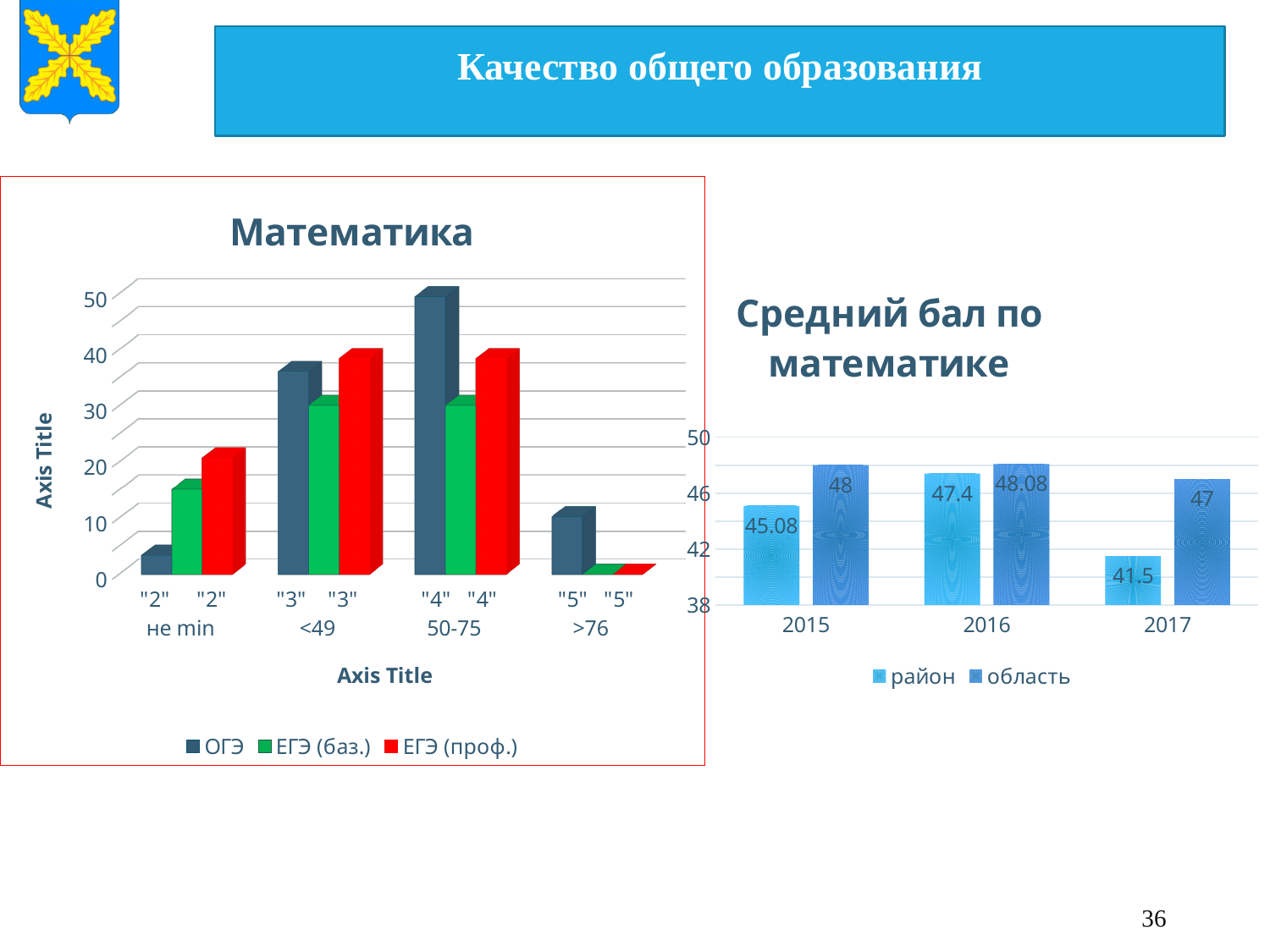
In the chart titled "Математика", how many series does the legend list? 3 In the chart titled "Средний бал по математике", what is the value for район in 2015? 45.08 In the chart titled "Средний бал по математике", what is the value for район in 2017? 41.5 In the chart titled "Математика", is the value of ЕГЭ (баз.) for "2" не min greater or less than 20? less In the chart titled "Средний бал по математике", which is larger in 2016: район or область? область In the chart titled "Средний бал по математике", which year has the lowest value for район? 2017 What kind of chart is the chart titled "Математика"? bar chart In the chart titled "Средний бал по математике", what is the value for область in 2016? 48.08 In the chart titled "Средний бал по математике", does the value for район rise or fall from 2016 to 2017? fall In the chart titled "Математика", is the value of ОГЭ for "4" 50-75 greater or less than 40? greater In the chart titled "Средний бал по математике", what is the difference between область and район in 2017? 5.5 In the chart titled "Средний бал по математике", how many series does the legend list? 2